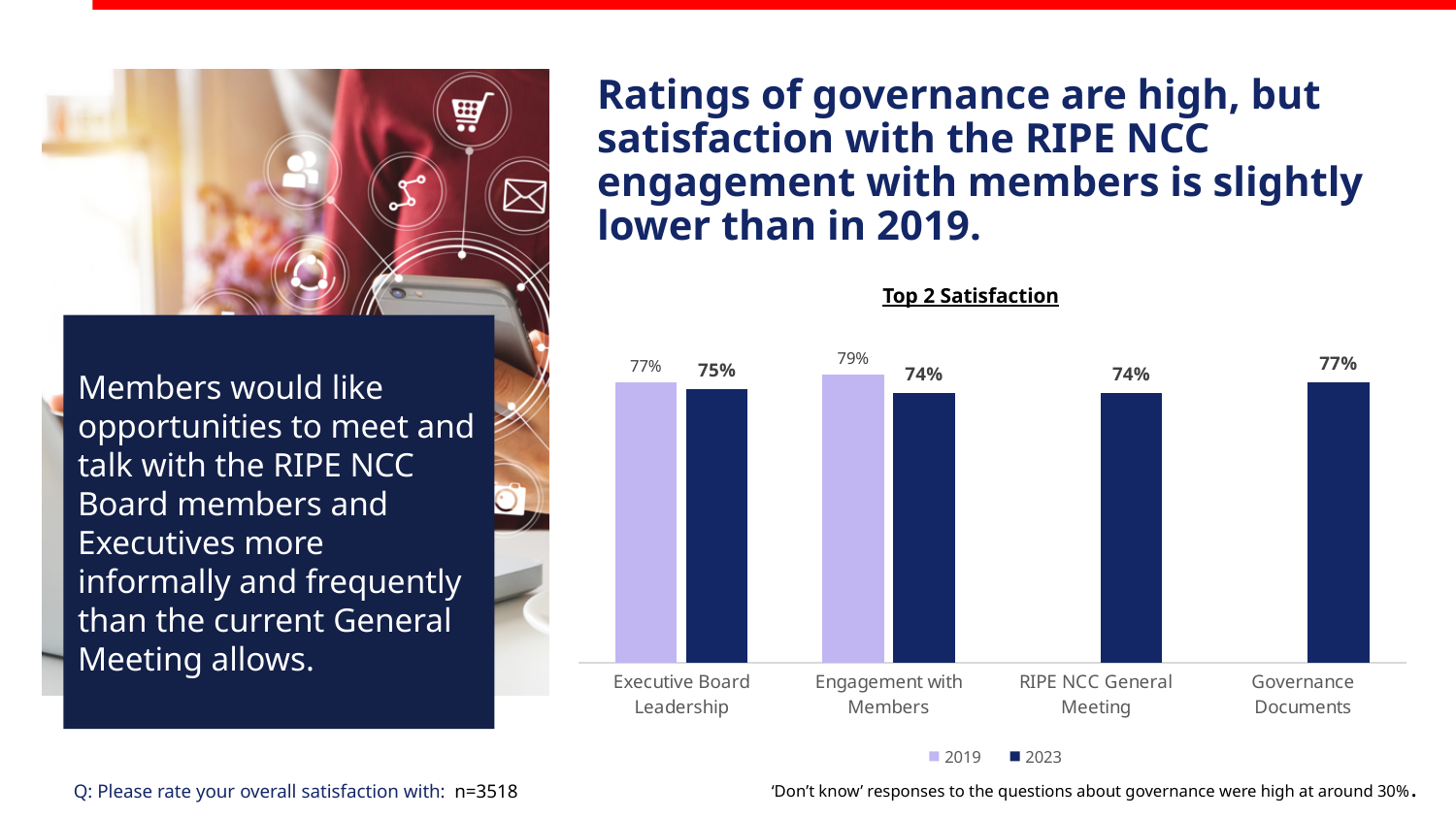
What is the difference between the 2019 and 2023 values for Executive Board Leadership? 2% Which is larger for Engagement with Members, the 2019 value or the 2023 value? 2019 What kind of chart is shown? Bar chart What is the difference between the 2019 and 2023 values for Engagement with Members? 5% How many categories are shown on the x axis? 4 What is the 2023 value for Executive Board Leadership? 75% What is the 2019 value for Engagement with Members? 79% Which category has the highest 2023 value? Governance Documents What is the 2019 value for Executive Board Leadership? 77% What is the 2023 value for Governance Documents? 77% How many series does the legend list? 2 What is the 2023 value for RIPE NCC General Meeting? 74%